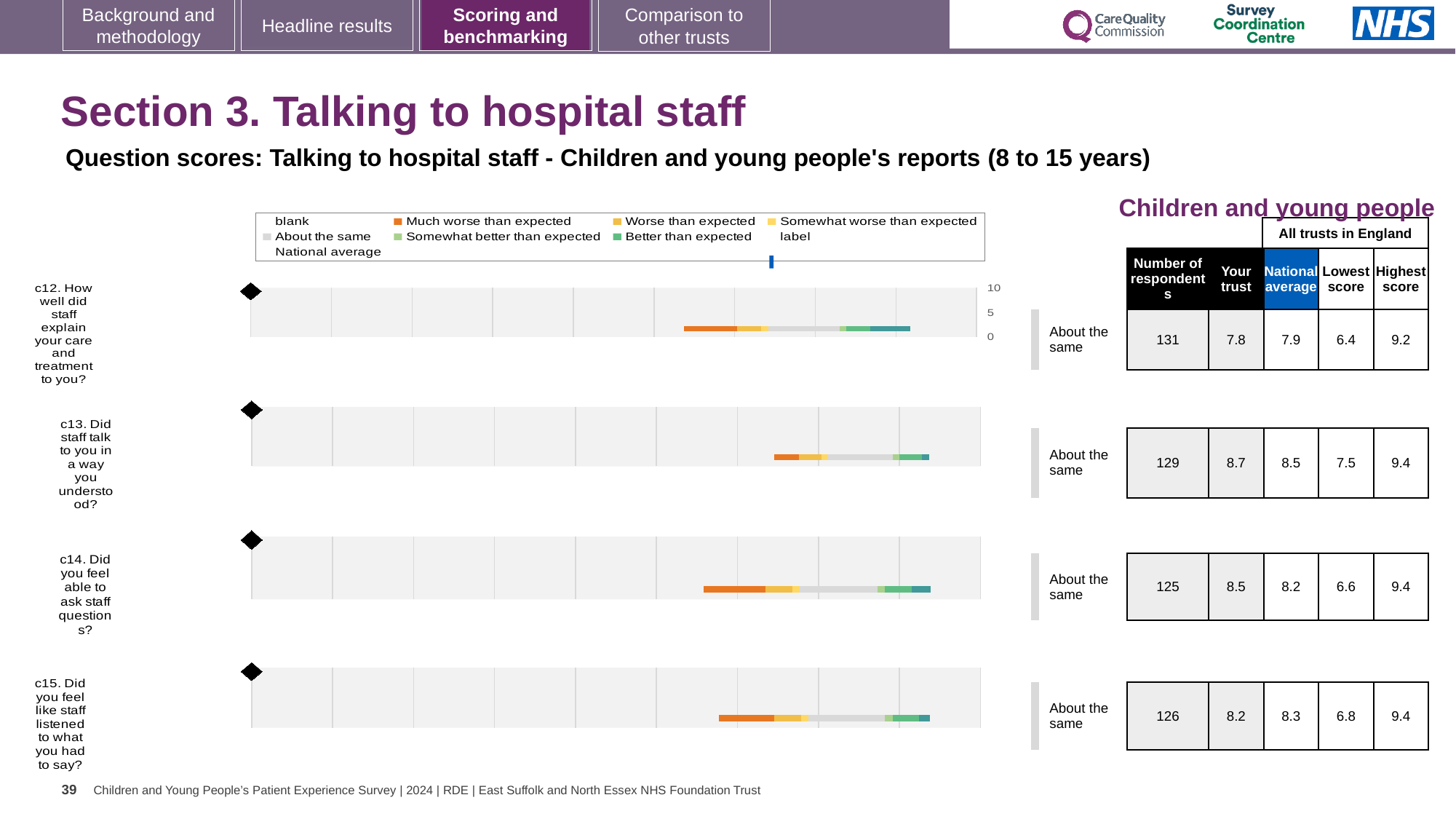
For c14, which is larger: the 'Your trust' score or the national average? Your trust Which question has the highest 'Your trust' score? c13. Did staff talk to you in a way you understood? How many survey questions are charted on this slide? 4 What is the lowest score among all trusts in England for c15 (Did you feel like staff listened to what you had to say?)? 6.8 Which question has the lowest 'Your trust' score? c12. How well did staff explain your care and treatment to you? What kind of chart is used to show the benchmark bands for each question? Bar chart For c15, which is larger: the 'Your trust' score or the national average? National average How many respondents answered c14 (Did you feel able to ask staff questions?)? 125 What is the 'Your trust' score for c12 (How well did staff explain your care and treatment to you?)? 7.8 For c12, what is the difference between the highest score and the lowest score among all trusts in England? 2.8 What benchmark label is shown next to the chart for c15? About the same What is the national average score for c13 (Did staff talk to you in a way you understood?)? 8.5